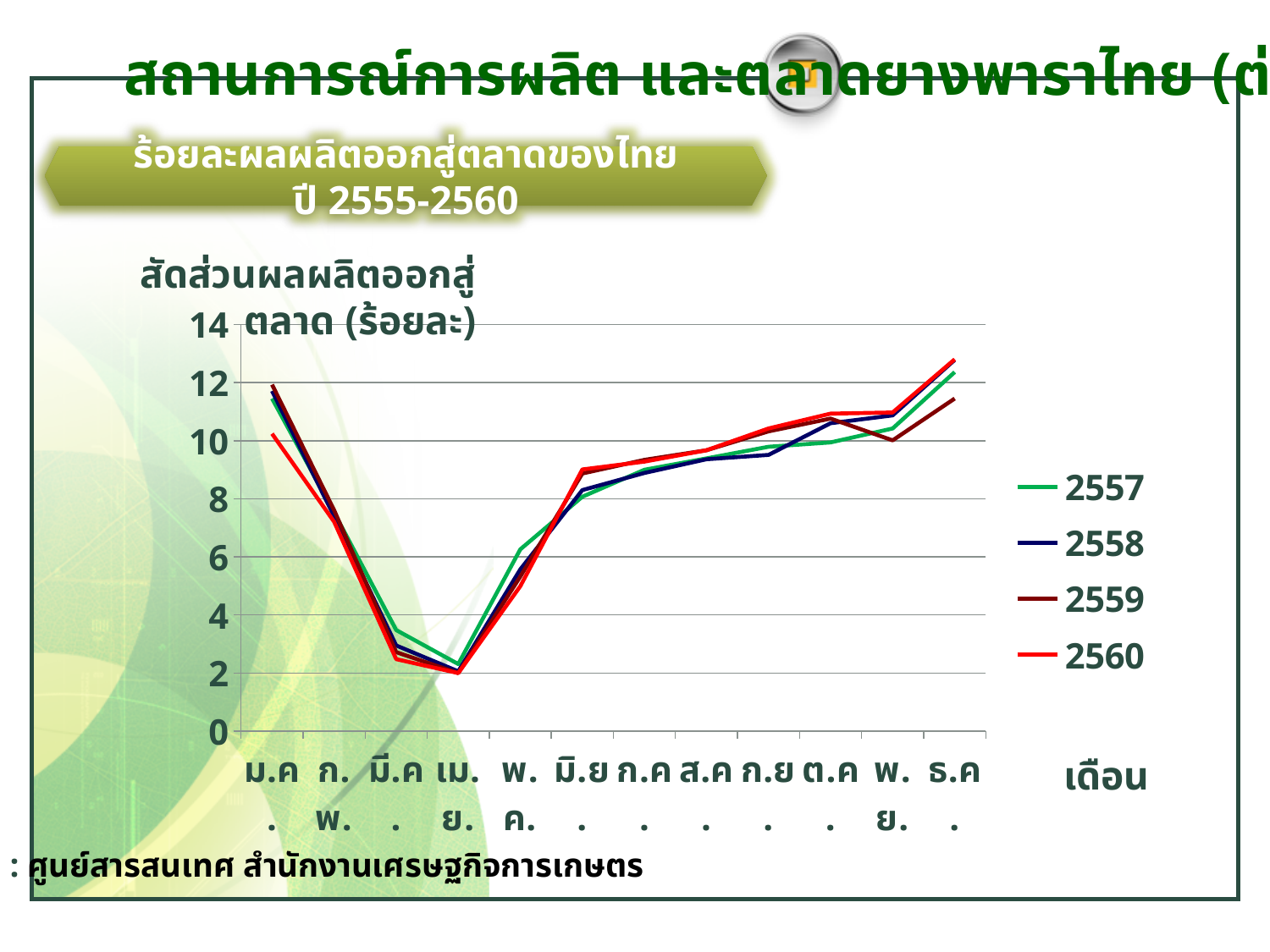
What kind of chart is shown on the slide? line chart How many months are shown along the x axis? 12 Is the value for 2560 in ธ.ค. greater or less than 12? greater Is the value for 2559 in ธ.ค. greater or less than 12? less Which is larger in ธ.ค., the value for 2560 or the value for 2559? 2560 What is the label of the y axis? สัดส่วนผลผลิตออกสู่ตลาด (ร้อยละ) In which month do all four series reach their lowest value? เม.ย. Is the value for 2557 in ม.ค. greater or less than 10? greater Which series are listed in the legend? 2557, 2558, 2559, 2560 How many series does the legend list? 4 Do the values rise or fall from ม.ค. to เม.ย.? fall